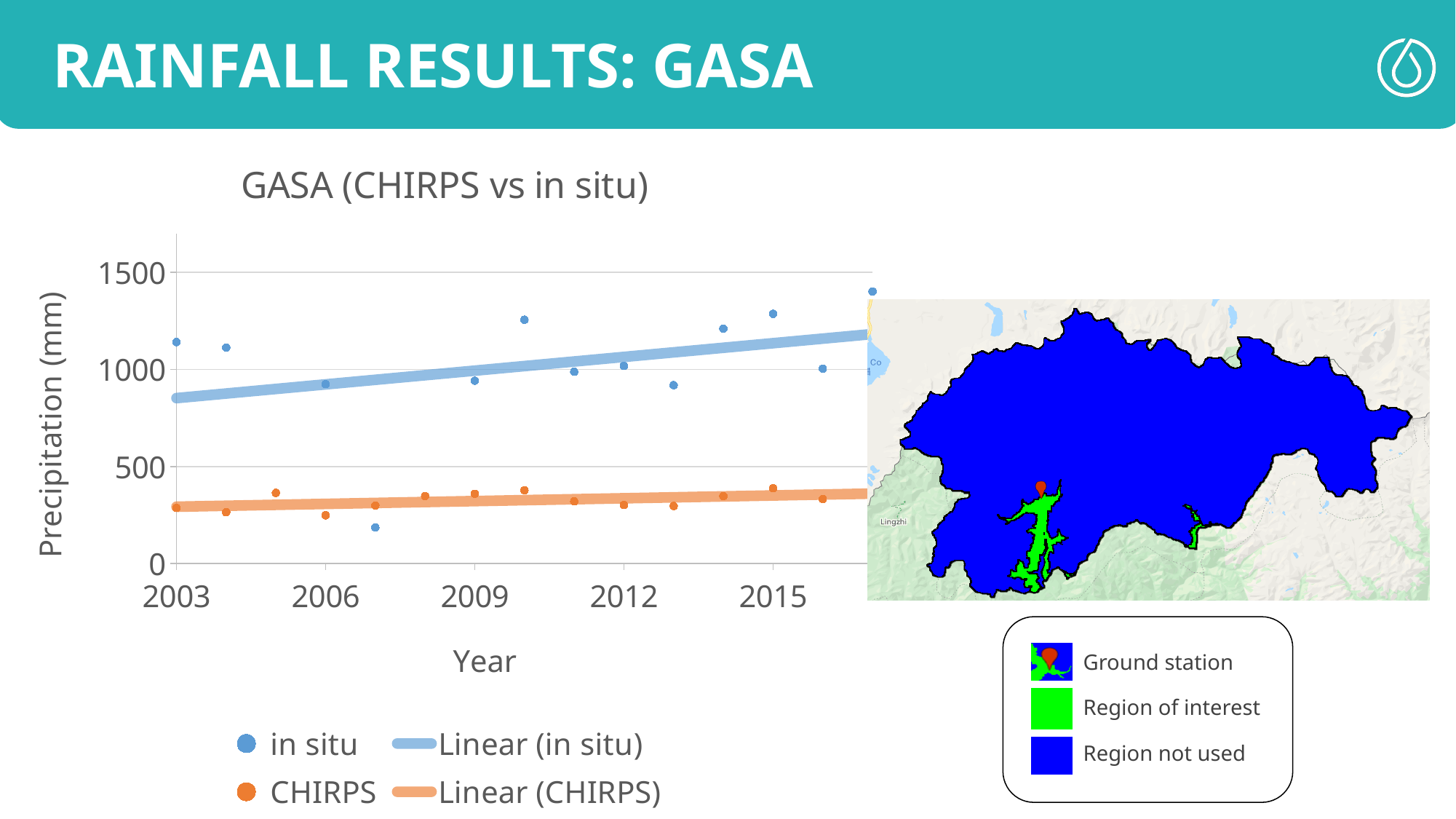
What is the label of the vertical axis of the chart? Precipitation (mm) What kind of chart is shown on the slide? Scatter chart Is the in situ value for 2007 greater or less than 500? less Is the in situ value for 2010 greater or less than 1000? greater In which year is the lowest in situ value plotted? 2007 Which is larger in 2003, the in situ value or the CHIRPS value? in situ Does the Linear (in situ) trendline rise or fall from 2003 to the right end of the chart? rise How many entries does the chart legend list? 4 Is the CHIRPS value for 2003 greater or less than 500? less What is the title of the chart? GASA (CHIRPS vs in situ)